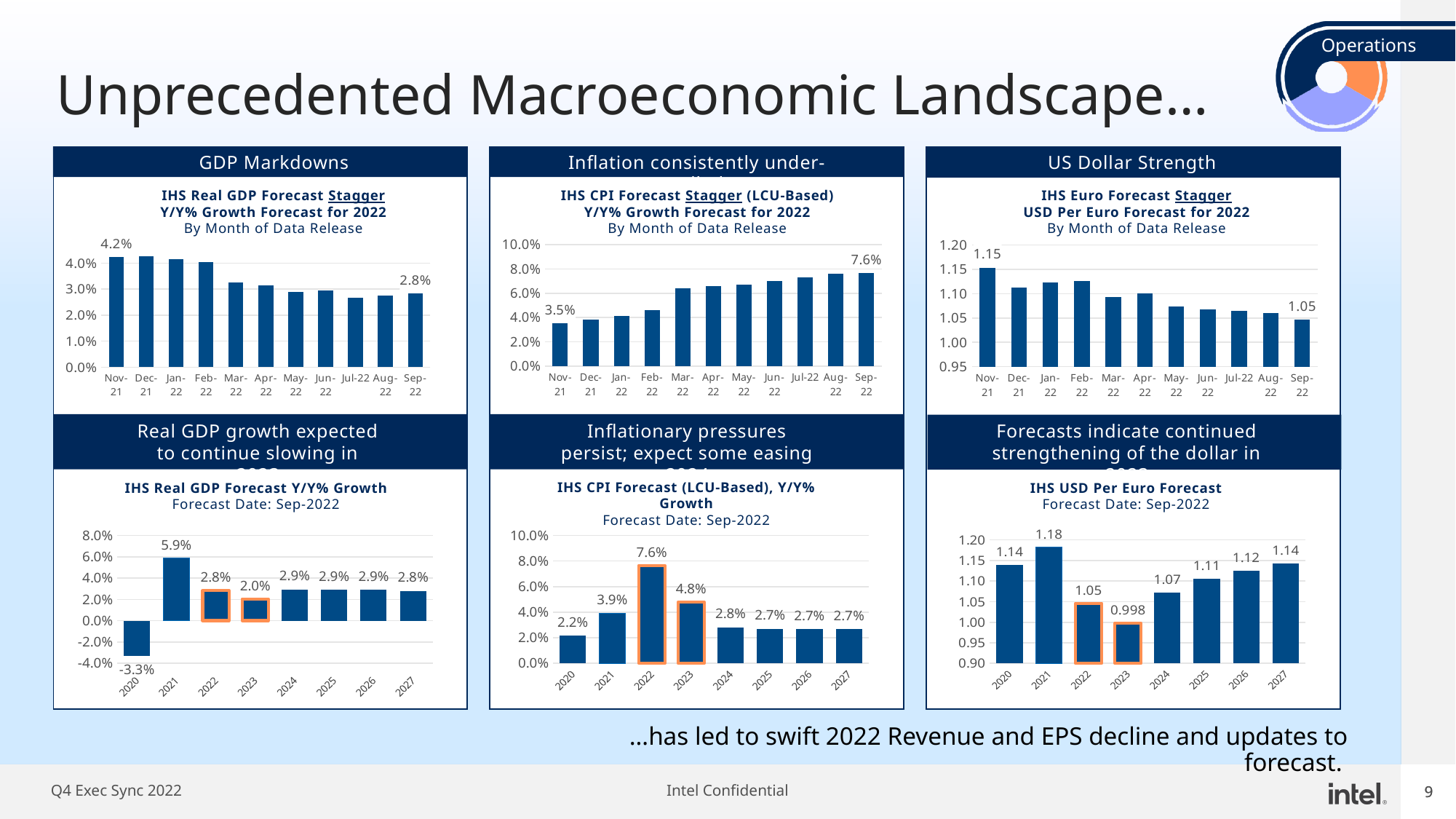
In the 'IHS Real GDP Forecast Stagger' chart (top left), what is the value for Nov-21? 4.2% In the 'IHS CPI Forecast Stagger (LCU-Based)' chart (top middle), what is the difference between the Sep-22 and Nov-21 values? 4.1% In the 'IHS CPI Forecast Stagger (LCU-Based)' chart (top middle), do the values rise or fall from Nov-21 to Sep-22? rise In the 'IHS USD Per Euro Forecast' chart (bottom right), which is larger, the value for 2021 or the value for 2027? 2021 In the 'IHS CPI Forecast (LCU-Based), Y/Y% Growth' chart (bottom middle), what is the value for 2023? 4.8% In the 'IHS Euro Forecast Stagger' chart (top right), what is the value for Sep-22? 1.05 In the 'IHS Real GDP Forecast Stagger' chart (top left), what is the value for Sep-22? 2.8% How many bars are in the 'IHS Real GDP Forecast Stagger' chart (top left)? 11 In the 'IHS Real GDP Forecast Y/Y% Growth' chart (bottom left), what is the value for 2020? -3.3% In the 'IHS Real GDP Forecast Y/Y% Growth' chart (bottom left), which year has the highest value? 2021 In the 'IHS USD Per Euro Forecast' chart (bottom right), which year has the lowest value? 2023